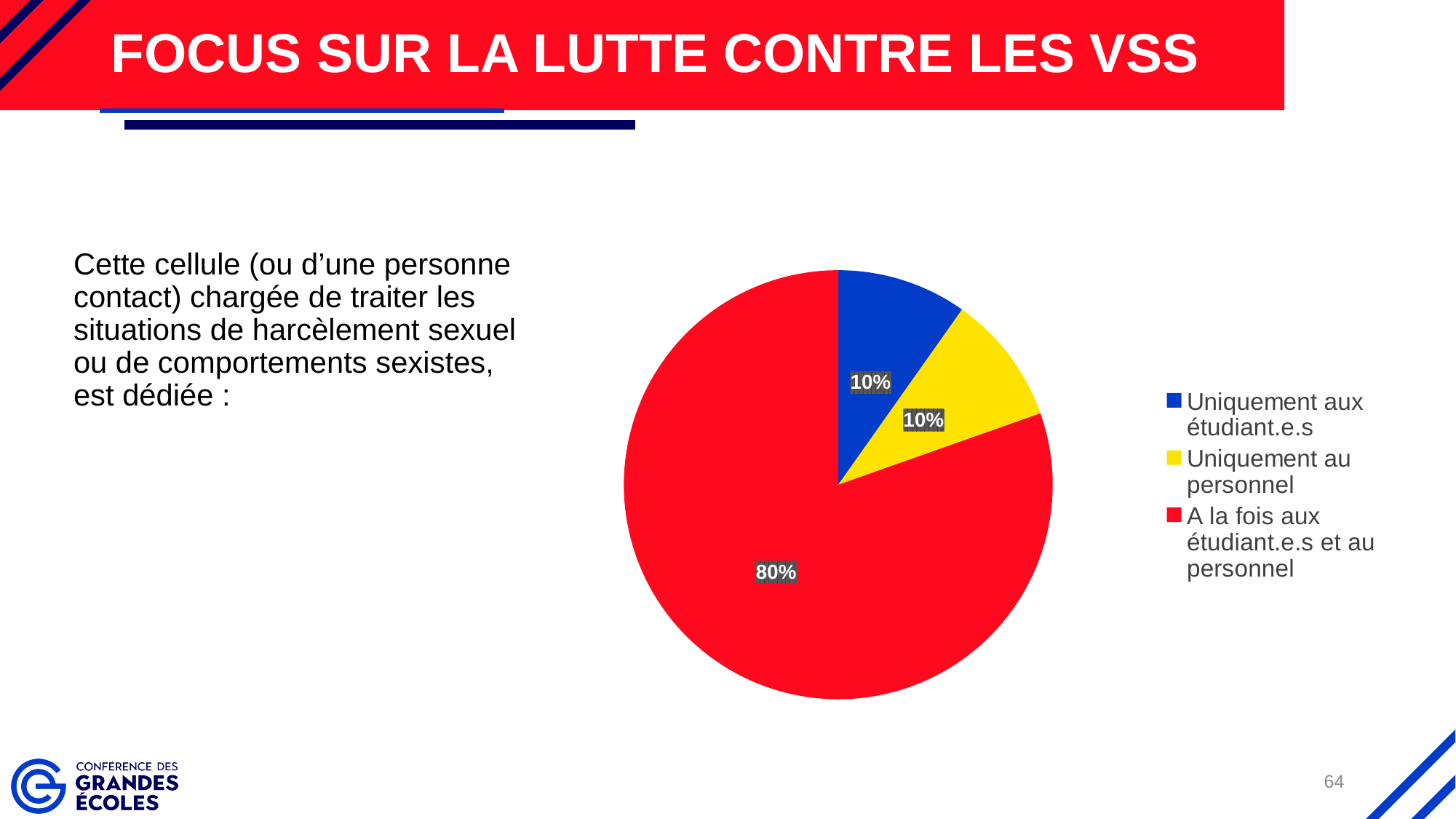
What is the value for 'Uniquement aux étudiant.e.s'? 10% What colour is the slice for 'Uniquement au personnel'? yellow What kind of chart is shown on the slide? pie chart Which category has the largest slice of the pie? A la fois aux étudiant.e.s et au personnel What is the value for 'Uniquement au personnel'? 10% What is the difference between the value for 'A la fois aux étudiant.e.s et au personnel' and the value for 'Uniquement au personnel'? 70% Which is larger: the slice for 'A la fois aux étudiant.e.s et au personnel' or the slice for 'Uniquement aux étudiant.e.s'? A la fois aux étudiant.e.s et au personnel What share of the pie is 'A la fois aux étudiant.e.s et au personnel'? 80% How many slices does the pie chart have? 3 What colour is the slice for 'A la fois aux étudiant.e.s et au personnel'? red How many entries does the legend list? 3